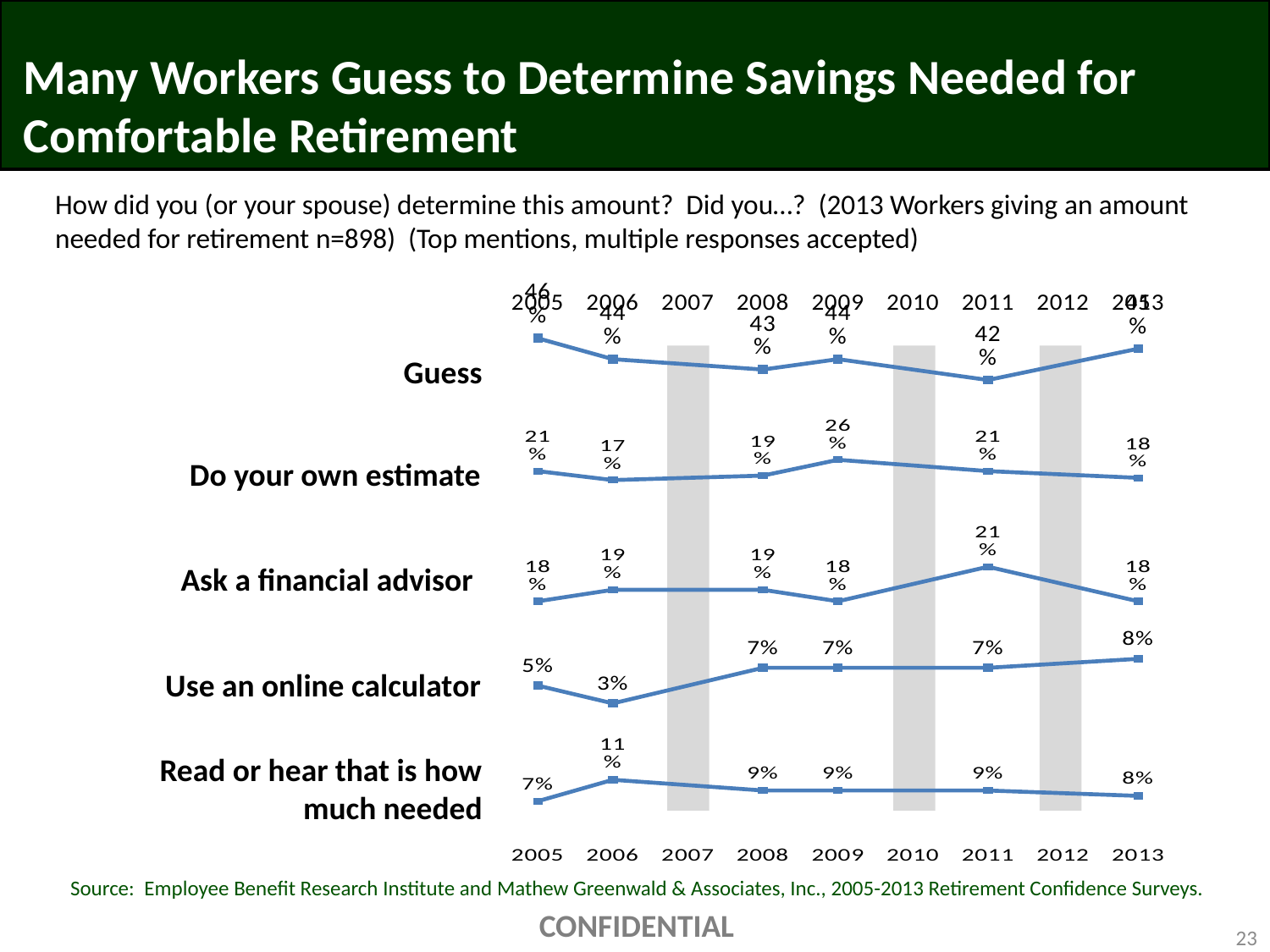
In the 'Ask a financial advisor' chart, what is the value for 2011? 21% How many years are labelled on the x axis of the charts? 9 In the 'Use an online calculator' chart, which year has the lowest value? 2006 In the 'Do your own estimate' chart, what is the difference between the 2009 value and the 2006 value? 9% In the 'Guess' chart, what is the difference between the 2005 value and the 2011 value? 4% In the 'Read or hear that is how much needed' chart, which is larger, the value for 2006 or the value for 2013? 2006 In the 'Do your own estimate' chart, which year has the highest value? 2009 In the 'Guess' chart, what is the value for 2011? 42% In the 'Read or hear that is how much needed' chart, what is the value for 2006? 11% In the 'Do your own estimate' chart, what is the value for 2009? 26% In the 'Use an online calculator' chart, what is the value for 2006? 3% What kind of chart is used to show each response category? Line chart